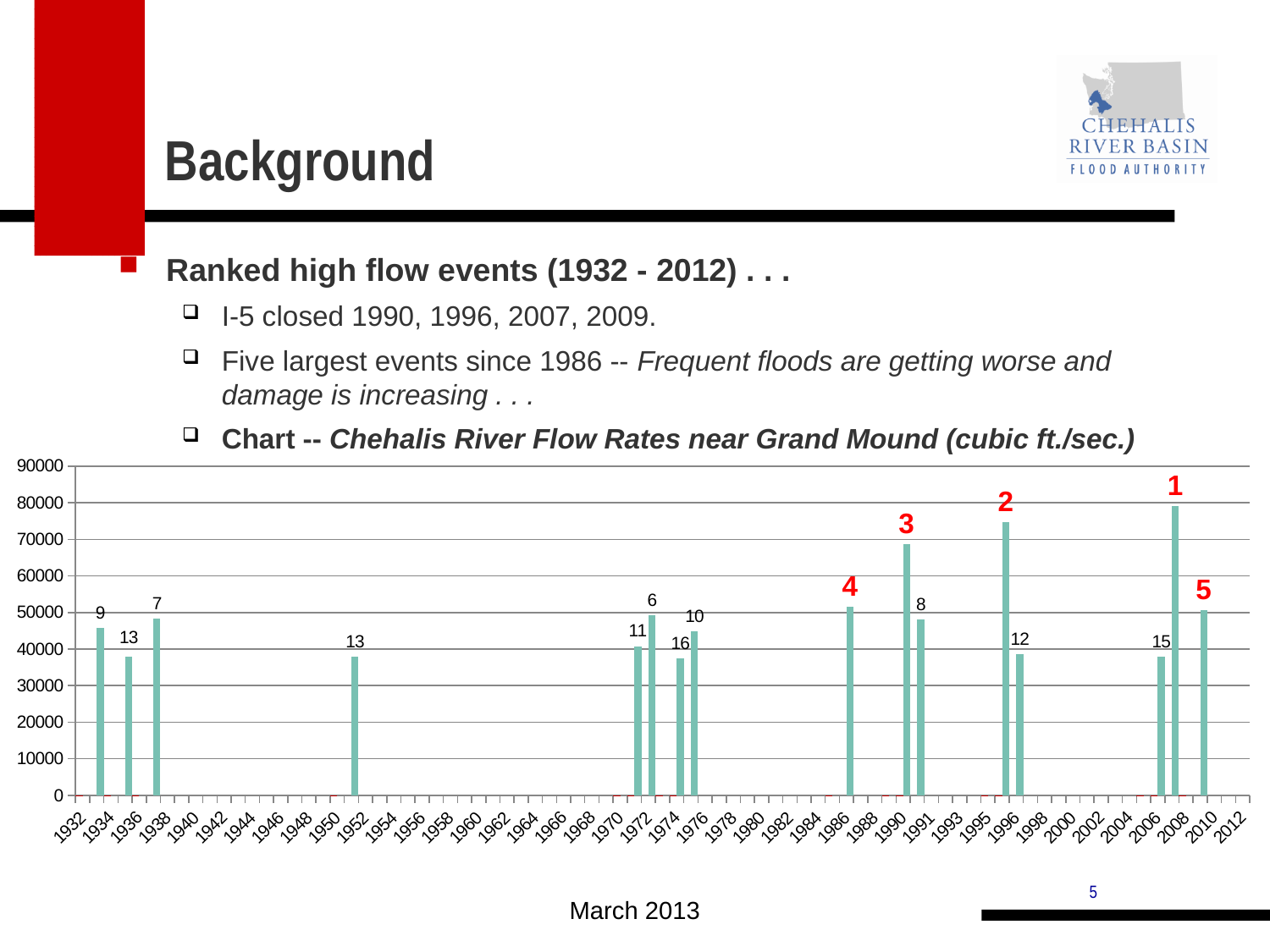
Which is taller, the bar labeled 1 or the bar labeled 2? the bar labeled 1 What is the highest value shown on the chart's vertical axis? 90000 Is the value of the bar labeled 3 greater or less than 60000? greater According to the slide, what does the chart show? Chehalis River Flow Rates near Grand Mound (cubic ft./sec.) What kind of chart is shown on the slide? bar chart Is the value of the bar labeled 2 greater or less than 70000? greater How many bars are plotted in the chart? 16 Which rank label is on the tallest bar in the chart? 1 Is the value of the bar labeled 4 greater or less than 60000? less